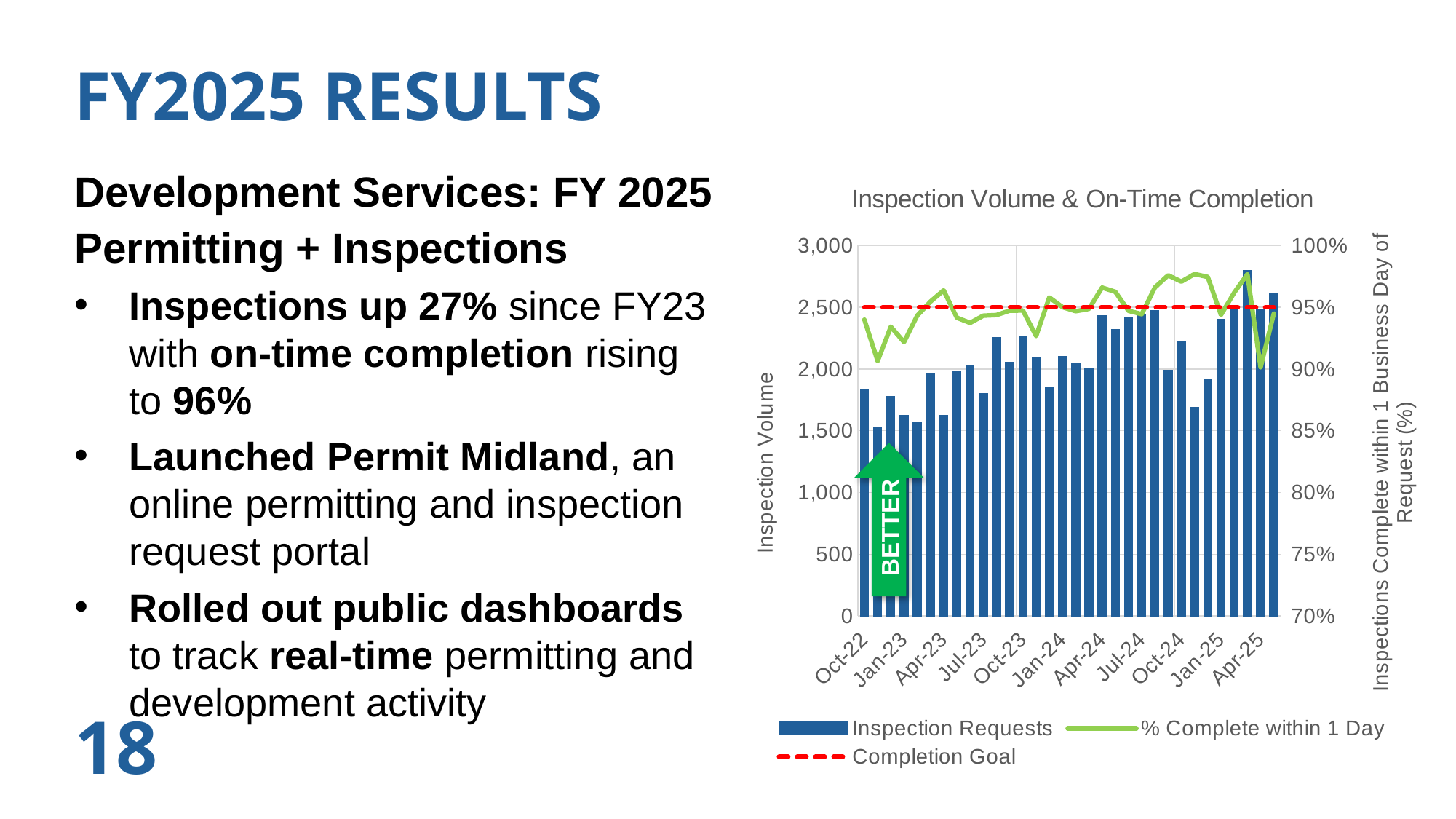
Is the Inspection Requests value for Jul-24 greater or less than 2,000? greater Which series is shown as a red dashed line in the chart? Completion Goal What is the title of the chart on the slide? Inspection Volume & On-Time Completion Is the % Complete within 1 Day value for Jan-23 greater or less than 95%? less Do the Inspection Requests bars generally rise or fall from Oct-22 to Apr-25? rise Is the Inspection Requests value for Jan-23 greater or less than 2,000? less How many month labels are shown on the x axis of the chart? 11 What type of chart is used to show Inspection Requests in the Inspection Volume & On-Time Completion chart? bar chart At what percentage does the Completion Goal line sit on the right axis? 95% How many series does the legend of the Inspection Volume & On-Time Completion chart list? 3